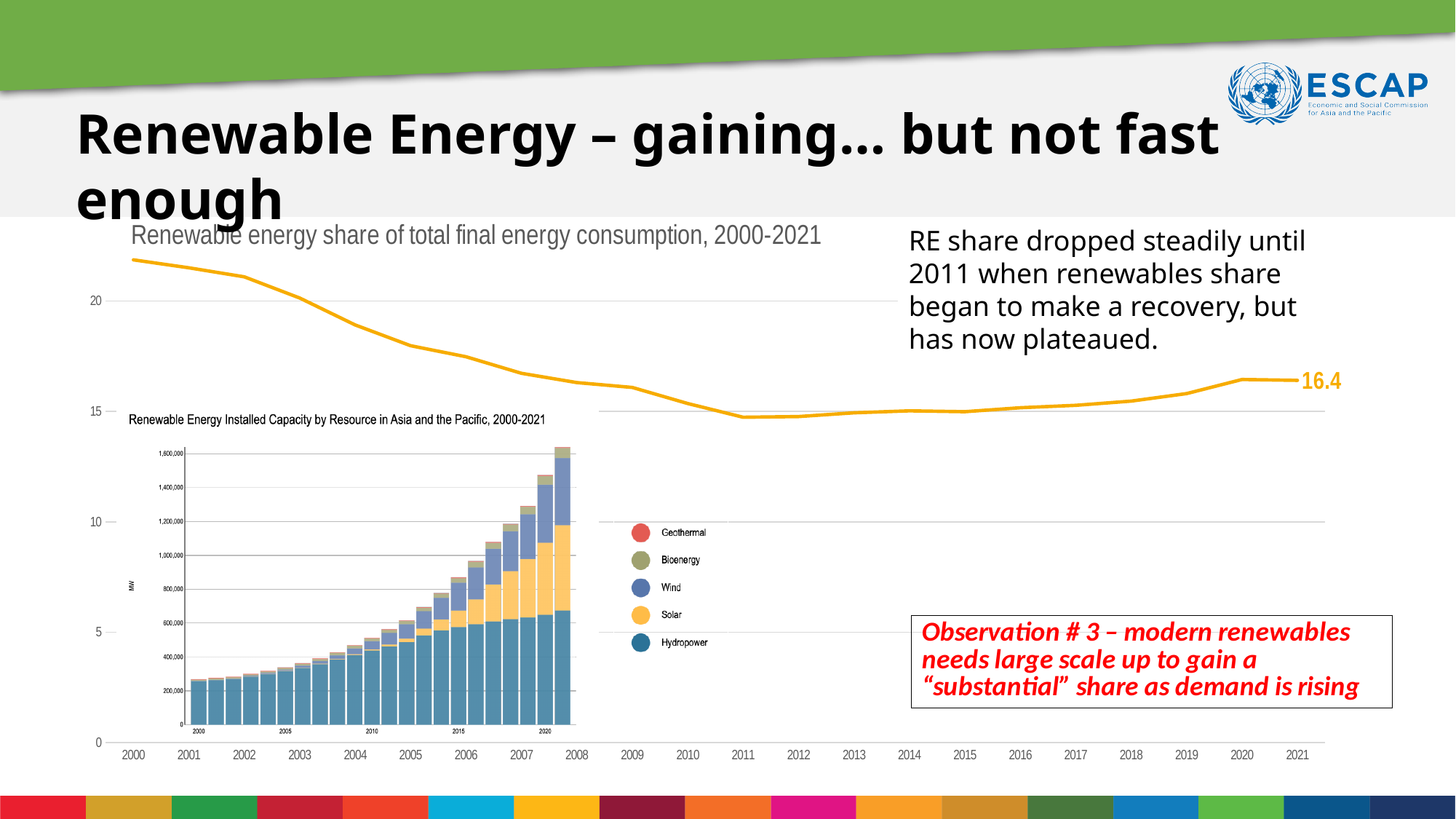
On the line chart 'Renewable energy share of total final energy consumption, 2000-2021', do the values rise or fall between 2011 and 2021? rise How many series does the legend list for the chart 'Renewable Energy Installed Capacity by Resource in Asia and the Pacific, 2000-2021'? 5 On the line chart 'Renewable energy share of total final energy consumption, 2000-2021', do the values rise or fall between 2000 and 2011? fall On the line chart 'Renewable energy share of total final energy consumption, 2000-2021', what value is labelled for 2021? 16.4 On the line chart 'Renewable energy share of total final energy consumption, 2000-2021', is the value for 2000 greater or less than 20? greater How many years are plotted on the x axis of the line chart 'Renewable energy share of total final energy consumption, 2000-2021'? 22 What kind of chart is 'Renewable Energy Installed Capacity by Resource in Asia and the Pacific, 2000-2021'? stacked bar chart On the line chart 'Renewable energy share of total final energy consumption, 2000-2021', is the value for 2011 greater or less than 15? less On the line chart 'Renewable energy share of total final energy consumption, 2000-2021', which year has the highest value? 2000 On the chart 'Renewable Energy Installed Capacity by Resource in Asia and the Pacific, 2000-2021', which series is shown at the bottom of each stacked bar? Hydropower On the chart 'Renewable Energy Installed Capacity by Resource in Asia and the Pacific, 2000-2021', is the total for 2021 greater or less than 1,400,000? greater What kind of chart is 'Renewable energy share of total final energy consumption, 2000-2021'? line chart